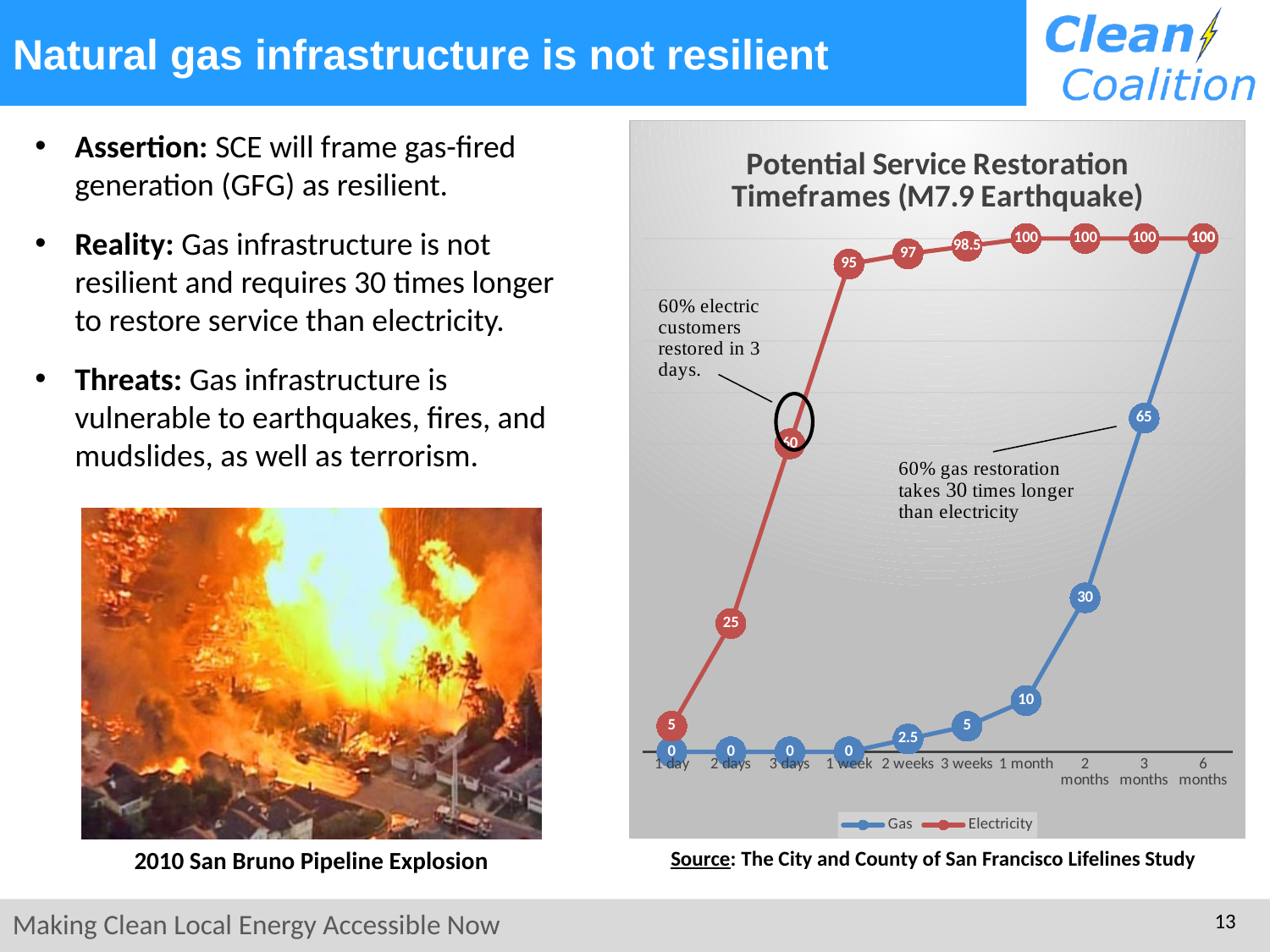
How many time categories are shown on the x axis of the chart? 10 What is the Gas value at 3 months? 65 Does the Gas series rise or fall along the x axis? Rise What is the Gas value at 2 months? 30 What kind of chart is shown on the slide? Line chart What is the Electricity value at 3 weeks? 98.5 What is the Gas value at 2 weeks? 2.5 What is the difference between the Electricity and Gas values at 1 week? 95 At 2 months, which series has the higher value, Gas or Electricity? Electricity How many series does the chart legend list? 2 What is the title of the chart? Potential Service Restoration Timeframes (M7.9 Earthquake) What is the Electricity value at 1 week? 95